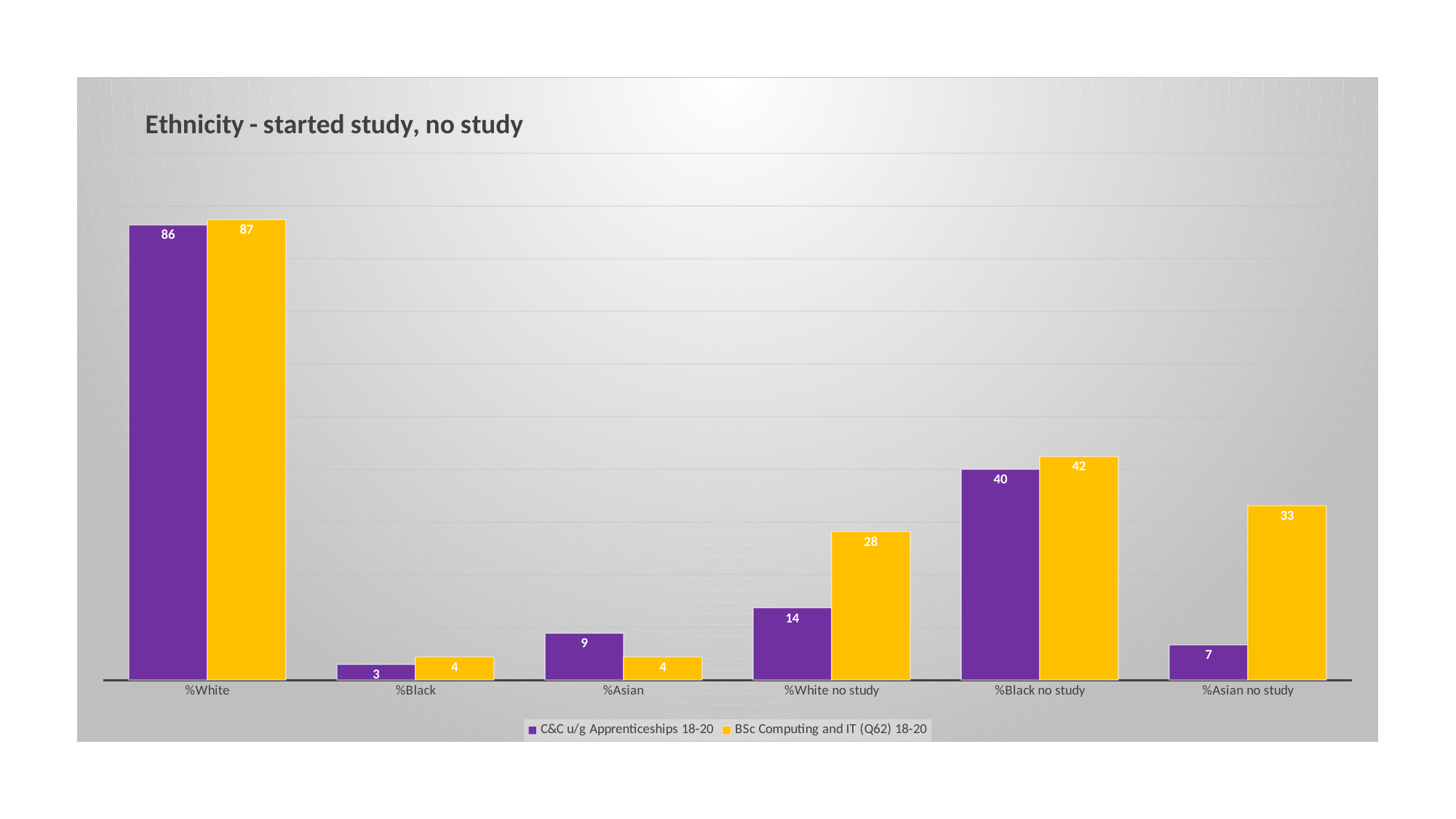
What is the value for %White in the C&C u/g Apprenticeships 18-20 series? 86 How many series does the legend list? 2 How many categories are shown on the x axis? 6 What is the value for %White no study in the C&C u/g Apprenticeships 18-20 series? 14 Which category has the highest value in the BSc Computing and IT (Q62) 18-20 series? %White What kind of chart is shown on the slide? Bar chart For %White no study, which series has the larger value? BSc Computing and IT (Q62) 18-20 What is the value for %Asian no study in the BSc Computing and IT (Q62) 18-20 series? 33 What is the difference between the BSc Computing and IT (Q62) 18-20 value and the C&C u/g Apprenticeships 18-20 value for %Asian no study? 26 What colour are the bars for the BSc Computing and IT (Q62) 18-20 series? Yellow Which category has the lowest value in the C&C u/g Apprenticeships 18-20 series? %Black What is the title of the chart? Ethnicity - started study, no study